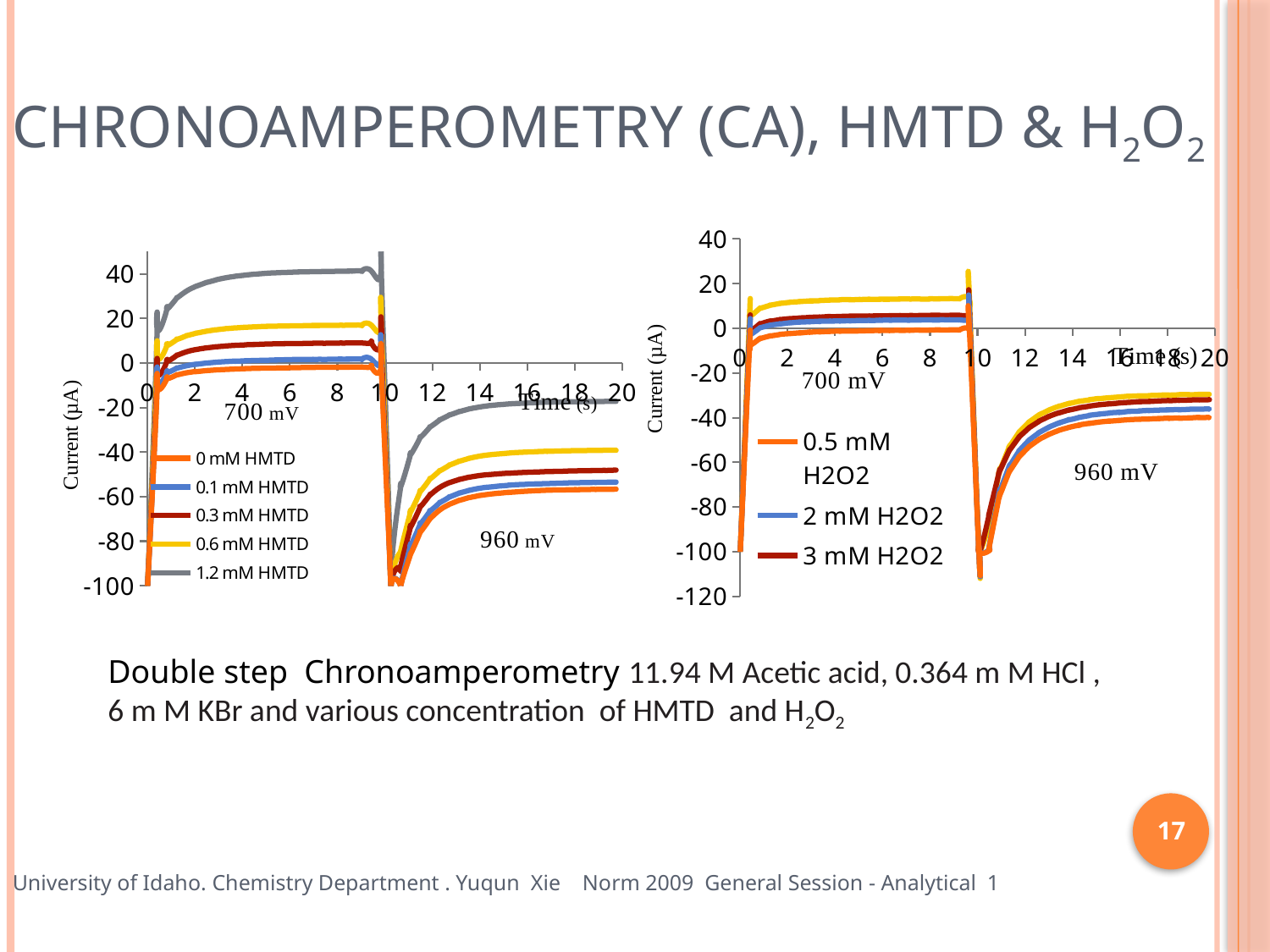
What is the y-axis label on the left chart? Current (µA) On the left chart, which series reaches the highest current during the 700 mV step (between 2 and 8 s)? 1.2 mM HMTD On the left chart, which series has the lowest current during the 700 mV step (between 2 and 8 s)? 0 mM HMTD On the left chart, how many series does the legend list? 5 On the right chart, how many series does the legend list? 3 On the left chart, is the current for 0.6 mM HMTD at 6 s greater or less than 40? less What kind of chart is the right chart? Line chart On the right chart, is the current for 0.5 mM H2O2 at 6 s greater or less than 20? less On the left chart, is the current for 1.2 mM HMTD at 6 s greater or less than 20? greater What kind of chart is the left chart? Line chart On the left chart, which is larger at 6 s: the current for 0.3 mM HMTD or for 0.1 mM HMTD? 0.3 mM HMTD